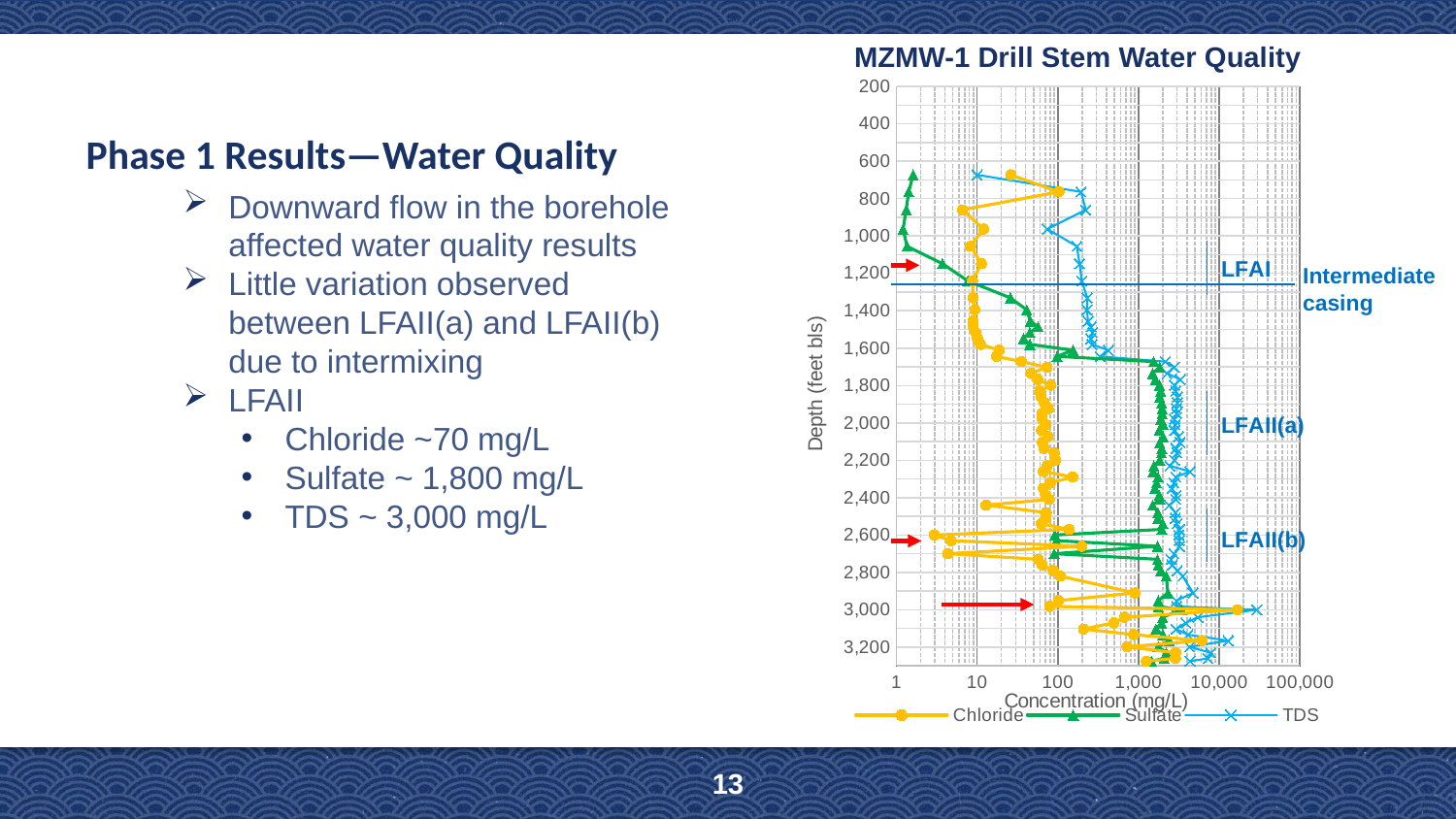
At a depth of 2,000 feet, which of the three series has the lowest concentration? Chloride What is the title of the chart? MZMW-1 Drill Stem Water Quality At a depth of 2,000 feet, is the TDS concentration greater or less than 1,000 mg/L? greater What kind of chart is shown on the slide? line chart What are the three series named in the chart legend? Chloride, Sulfate, TDS At a depth of 2,000 feet, is the Chloride concentration greater or less than 100 mg/L? less At a depth of 1,400 feet, is the TDS concentration greater or less than 1,000 mg/L? less Between depths of 1,400 and 2,000 feet, does the TDS concentration rise or fall? rise At a depth of 2,000 feet, which series has the higher concentration, Chloride or TDS? TDS How many series does the legend of the chart list? 3